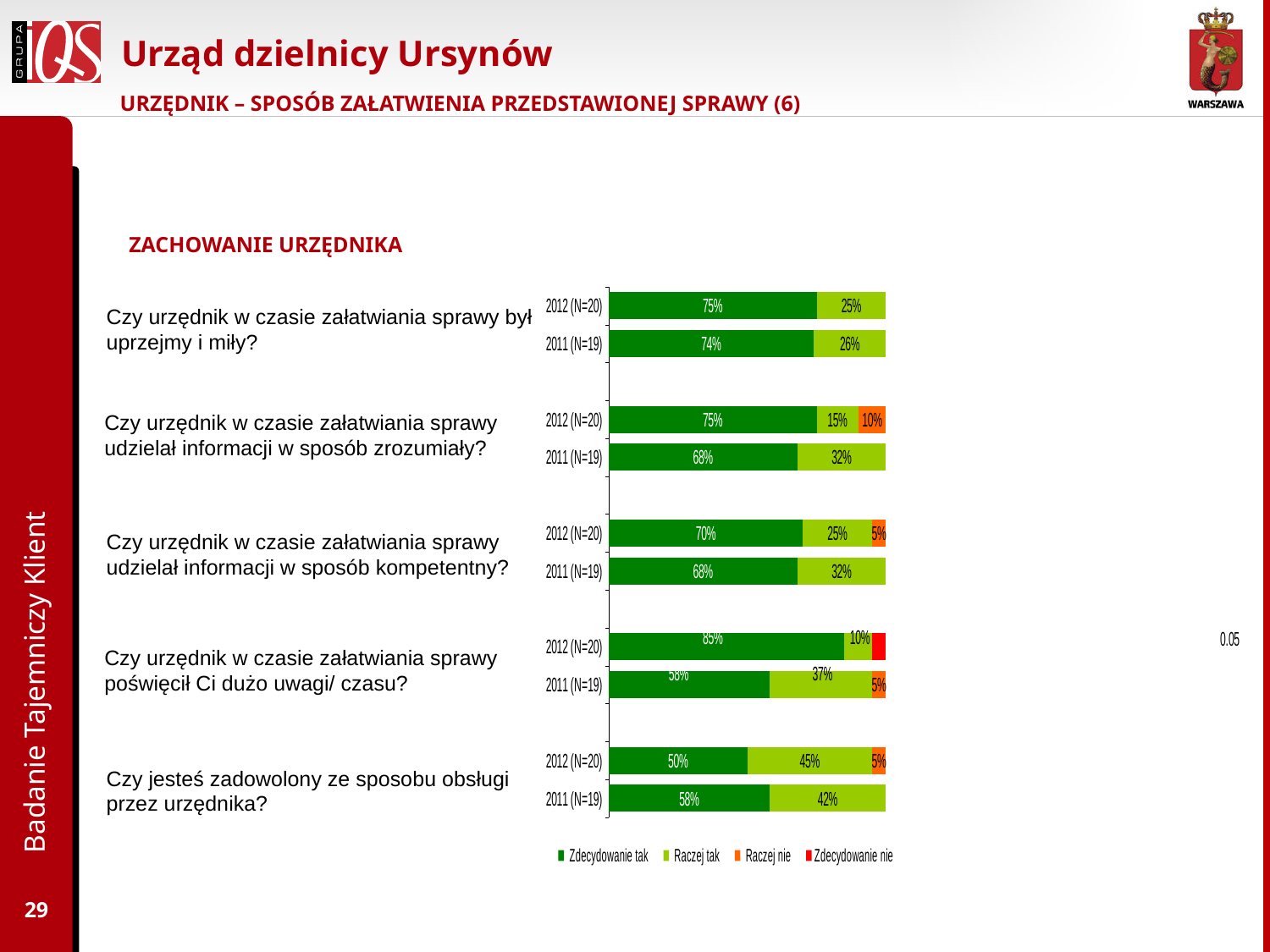
Which bar has the lowest "Zdecydowanie tak" share? 2012 (N=20) for "Czy jesteś zadowolony ze sposobu obsługi przez urzędnika?" (50%) What is the combined share of "Zdecydowanie tak" and "Raczej tak" in 2012 (N=20) for "Czy jesteś zadowolony ze sposobu obsługi przez urzędnika?"? 95% For "Czy jesteś zadowolony ze sposobu obsługi przez urzędnika?", by how many percentage points did the "Zdecydowanie tak" share fall from 2011 to 2012? 8 percentage points What percentage answered "Zdecydowanie tak" in 2012 (N=20) to the question "Czy urzędnik w czasie załatwiania sprawy poświęcił Ci dużo uwagi/ czasu?"? 85% What percentage answered "Raczej nie" in 2012 (N=20) to the question "Czy urzędnik w czasie załatwiania sprawy udzielał informacji w sposób zrozumiały?"? 10% For "Czy urzędnik w czasie załatwiania sprawy udzielał informacji w sposób kompetentny?", which year had the larger "Zdecydowanie tak" share, 2012 or 2011? 2012 (70% vs 68%) Which bar has the highest "Zdecydowanie tak" share? 2012 (N=20) for "Czy urzędnik w czasie załatwiania sprawy poświęcił Ci dużo uwagi/ czasu?" (85%) What kind of chart is shown on the slide? Stacked horizontal bar chart How many series does the legend list? 4 How many bars are plotted in the chart? 10 What percentage answered "Zdecydowanie tak" in 2012 (N=20) to the question "Czy urzędnik w czasie załatwiania sprawy był uprzejmy i miły?"? 75% What percentage answered "Raczej tak" in 2011 (N=19) to the question "Czy urzędnik w czasie załatwiania sprawy udzielał informacji w sposób zrozumiały?"? 32%